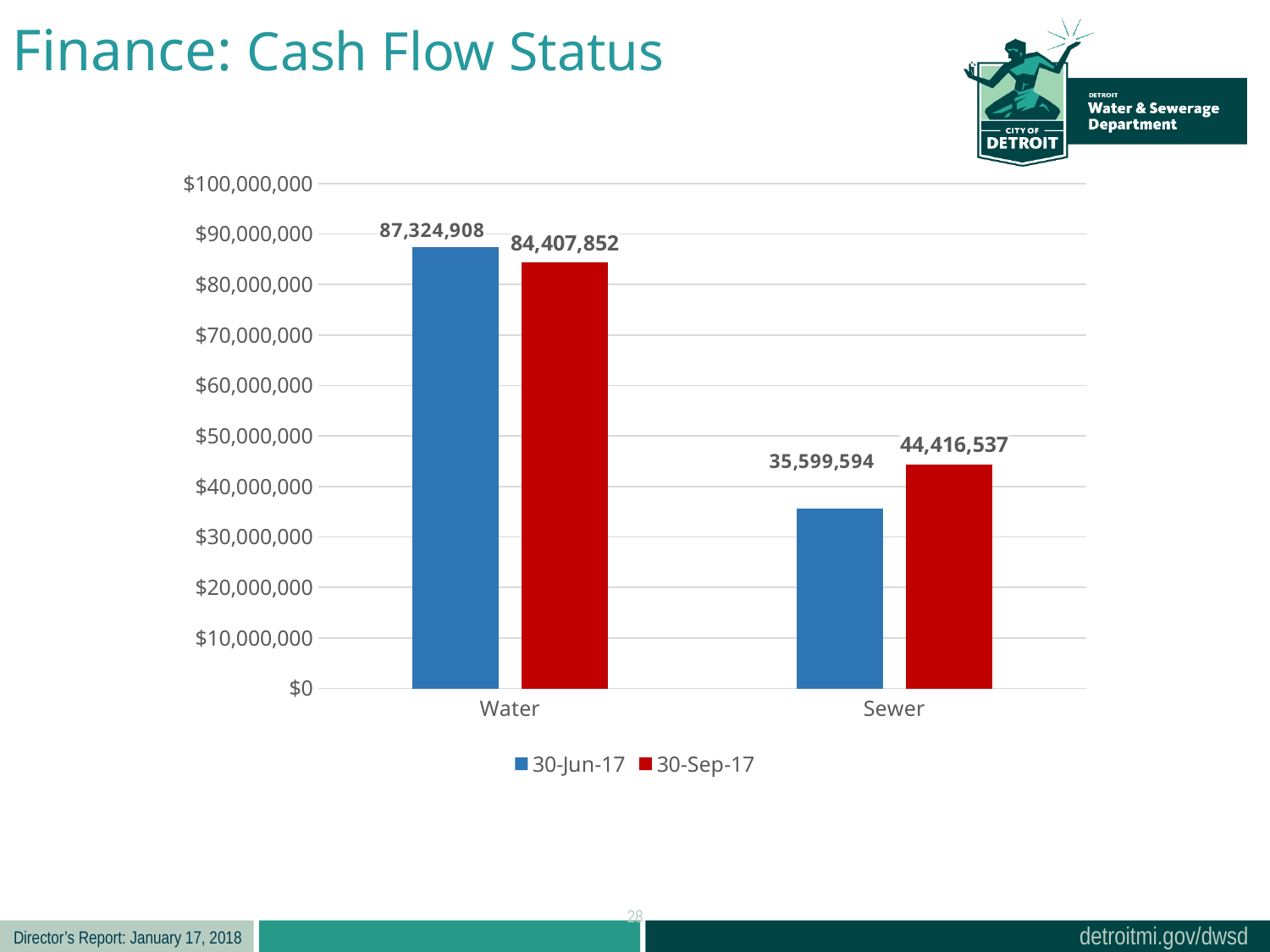
What kind of chart is shown on the slide? Bar chart How many series does the legend list? 2 What is the value for Sewer on 30-Jun-17? 35,599,594 What is the value for Sewer on 30-Sep-17? 44,416,537 Which bar has the highest value on the chart? Water, 30-Jun-17 What is the difference between the Sewer values for 30-Sep-17 and 30-Jun-17? 8,816,943 What is the difference between the Water values for 30-Jun-17 and 30-Sep-17? 2,917,056 For Sewer, which is larger: the 30-Jun-17 value or the 30-Sep-17 value? 30-Sep-17 What is the value for Water on 30-Jun-17? 87,324,908 Which bar has the lowest value on the chart? Sewer, 30-Jun-17 What is the value for Water on 30-Sep-17? 84,407,852 How many categories are shown on the x axis? 2